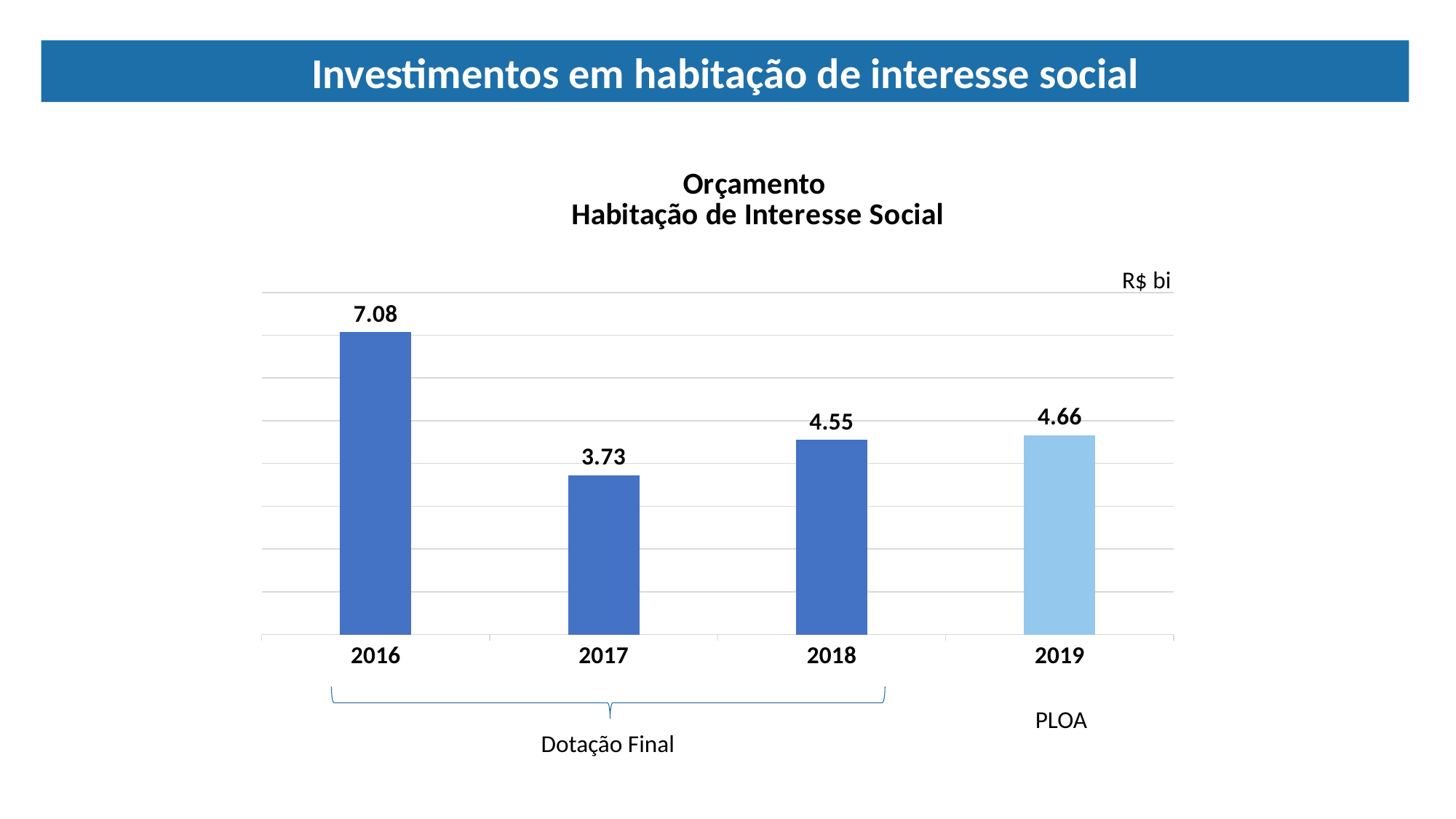
What is the difference between the values for 2016 and 2017? 3.35 What is the value for 2019? 4.66 What is the difference between the values for 2019 and 2018? 0.11 Which is larger, the value for 2016 or the value for 2018? 2016 Which year has the highest value? 2016 What unit is indicated at the top right of the chart? R$ bi How many years are shown on the x axis? 4 What kind of chart is this? Bar chart What is the value for 2017? 3.73 What is the value for 2016? 7.08 What is the value for 2018? 4.55 Which year has the lowest value? 2017